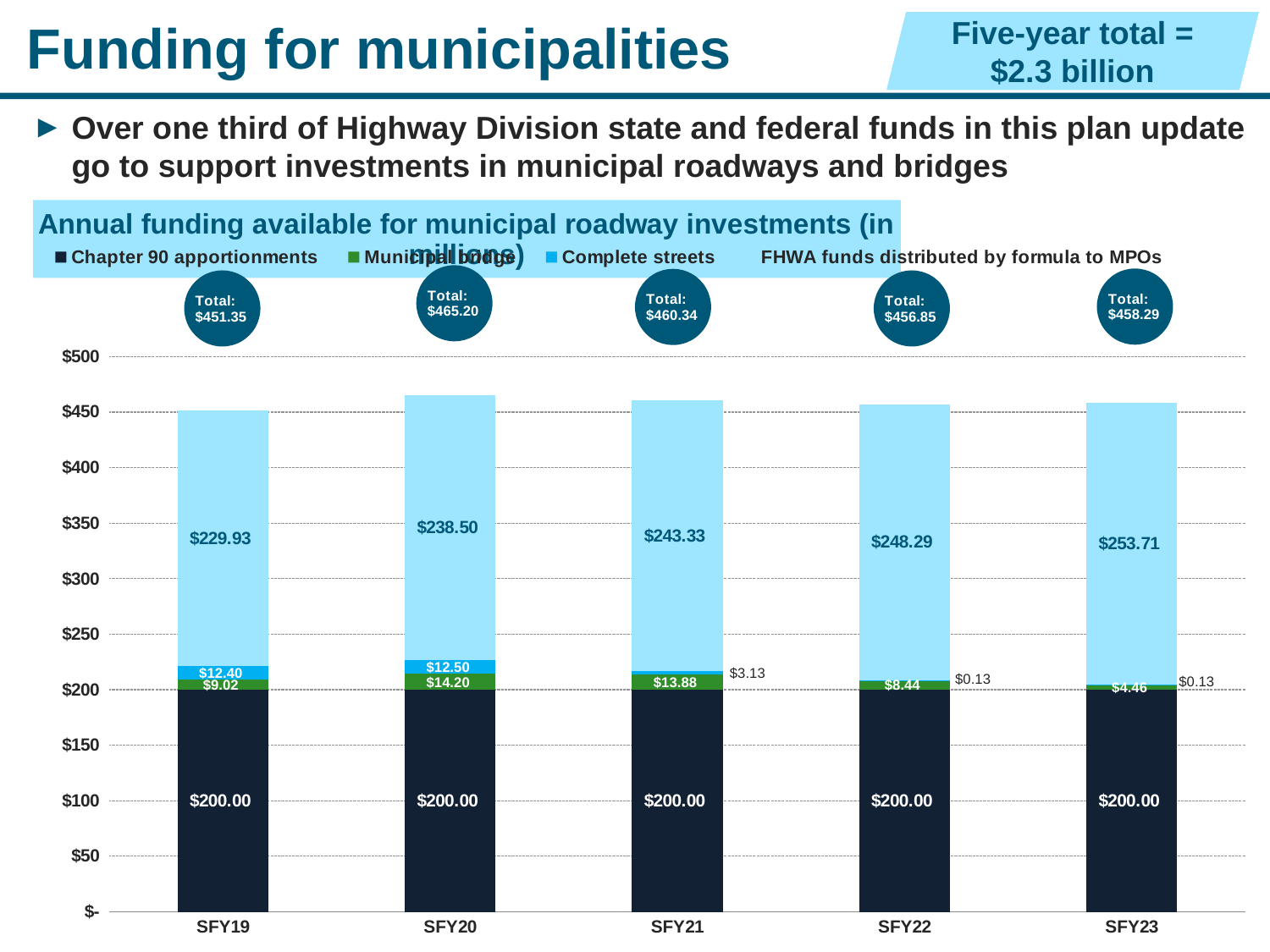
Which fiscal year has the lowest total? SFY19 What is the FHWA funds distributed by formula to MPOs value for SFY21? $243.33 What is the Complete streets value for SFY19? $12.40 Do the FHWA funds distributed by formula to MPOs values rise or fall from SFY19 to SFY23? Rise What is the total shown for the SFY20 bar? $465.20 Which is larger, the Municipal bridge value for SFY21 or for SFY22? SFY21 Which fiscal year has the highest total? SFY20 How many series does the legend list? 4 What is the difference between the FHWA funds distributed by formula to MPOs values for SFY23 and SFY19? $23.78 What kind of chart is shown on the slide? Stacked bar chart What is the Municipal bridge value for SFY20? $14.20 How many fiscal years are shown on the x axis? 5